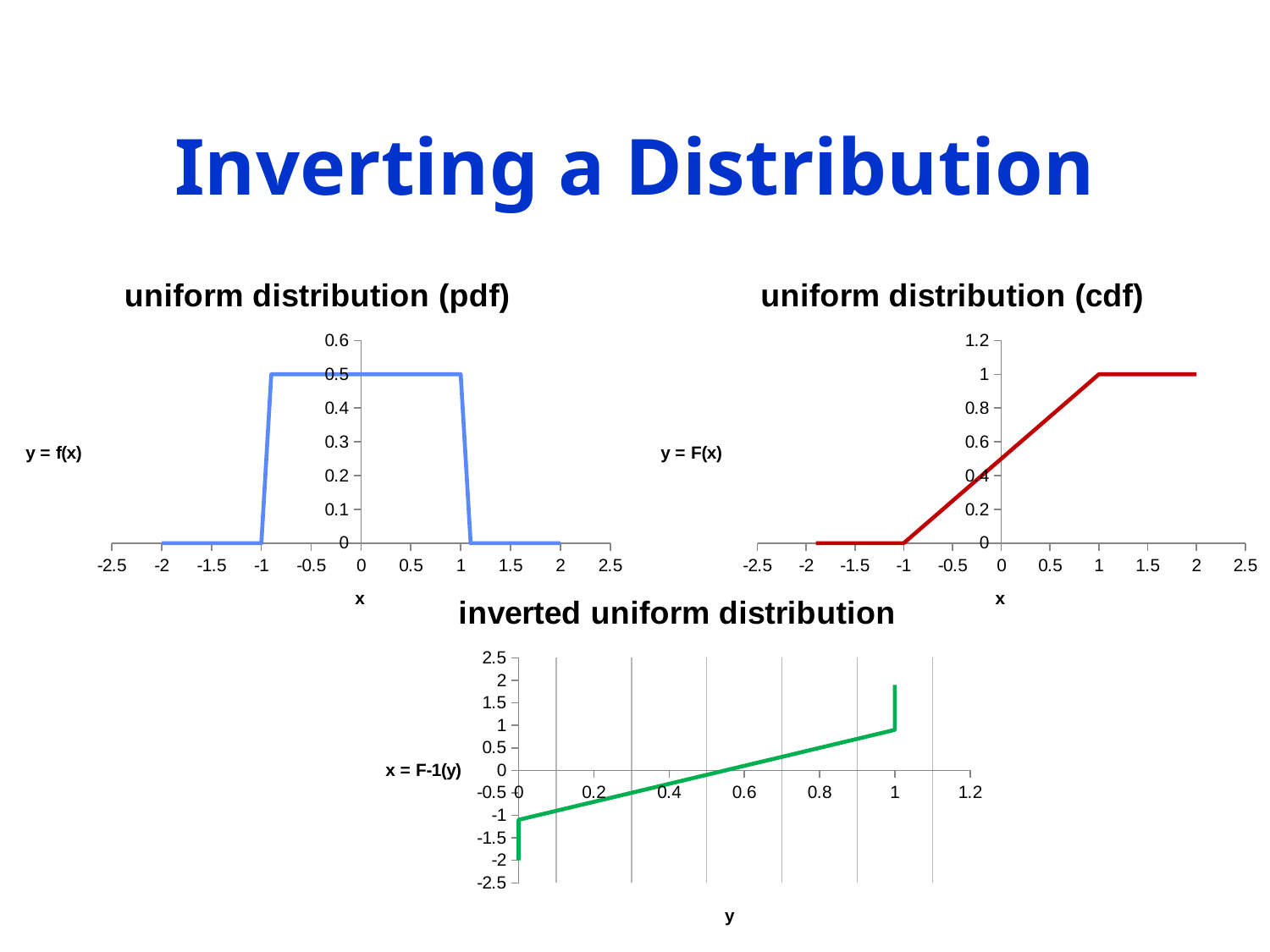
In the 'uniform distribution (cdf)' chart, what is the value of y = F(x) at x = 1.5? 1 In the 'uniform distribution (pdf)' chart, what is the value of y = f(x) on the flat section between x = -1 and x = 1? 0.5 In the 'inverted uniform distribution' chart, is the value of x = F-1(y) at y = 0.2 greater or less than 0? less In the 'uniform distribution (pdf)' chart, what is the value of y = f(x) at x = 2? 0 What kind of chart is the 'uniform distribution (pdf)' chart? line chart What is the x-axis label of the 'inverted uniform distribution' chart? y In the 'uniform distribution (cdf)' chart, does the line rise or fall between x = -1 and x = 1? rise In the 'uniform distribution (cdf)' chart, what is the value of y = F(x) at x = -1.5? 0 In the 'uniform distribution (cdf)' chart, is the value of y = F(x) at x = 0 greater or less than 0.4? greater In the 'inverted uniform distribution' chart, does the line rise or fall as y increases from 0 to 1? rise How many charts are shown on the slide? 3